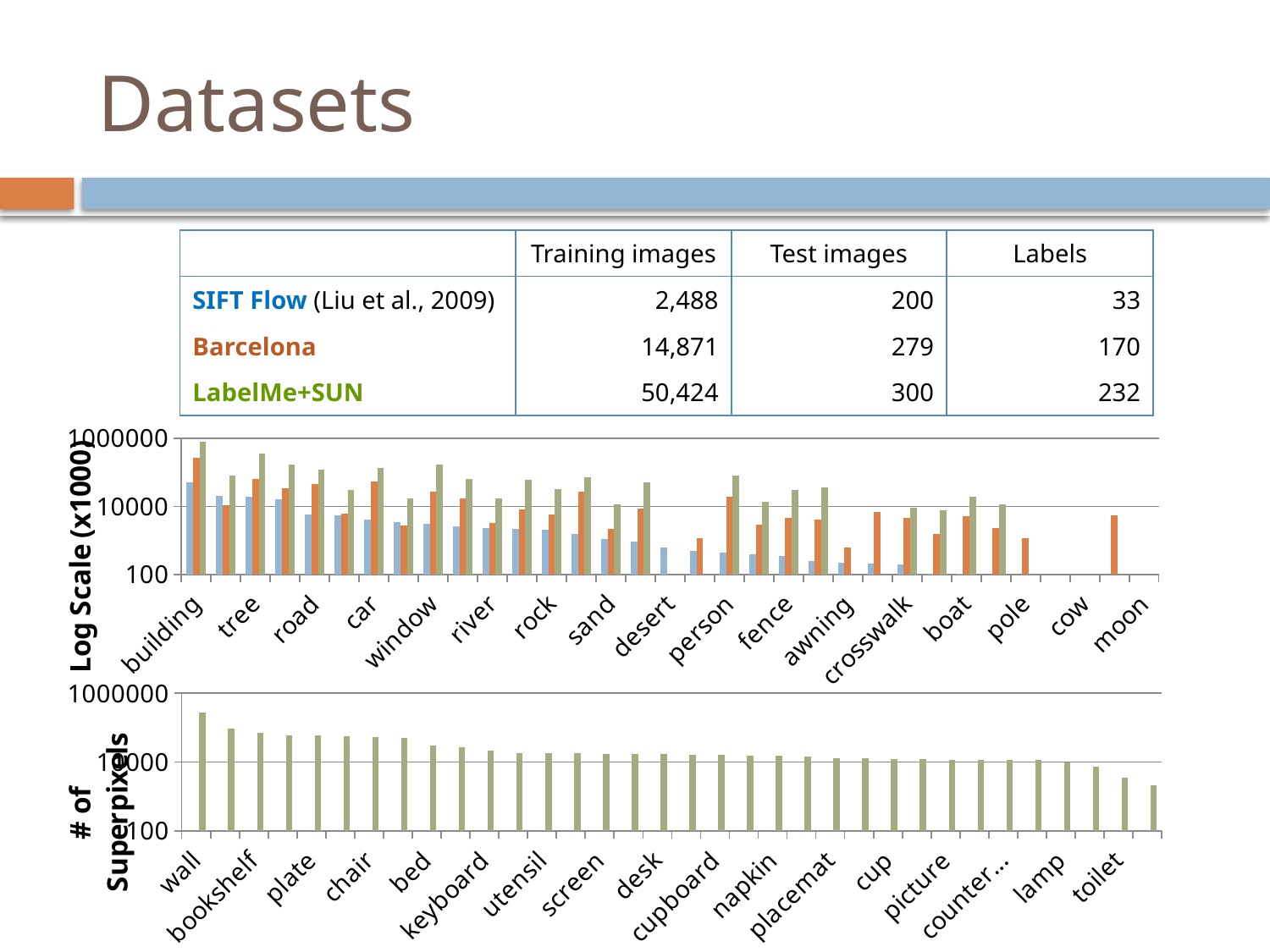
In the bottom chart, which category has the highest value? wall What is the y-axis label of the top chart? Log Scale (x1000) In the bottom chart, is the value for toilet greater or less than 10000? less In the bottom chart, which is larger, the value for wall or the value for toilet? wall In the top chart, is the tallest bar for building greater or less than 10000? greater What kind of chart is the bottom chart on the slide? bar chart What kind of chart is the top chart on the slide? bar chart What is the y-axis label of the bottom chart? # of Superpixels In the bottom chart, do the values rise or fall from left to right along the x axis? fall In the bottom chart, which labeled category has the lowest value? toilet In the bottom chart, is the value for wall greater or less than 10000? greater